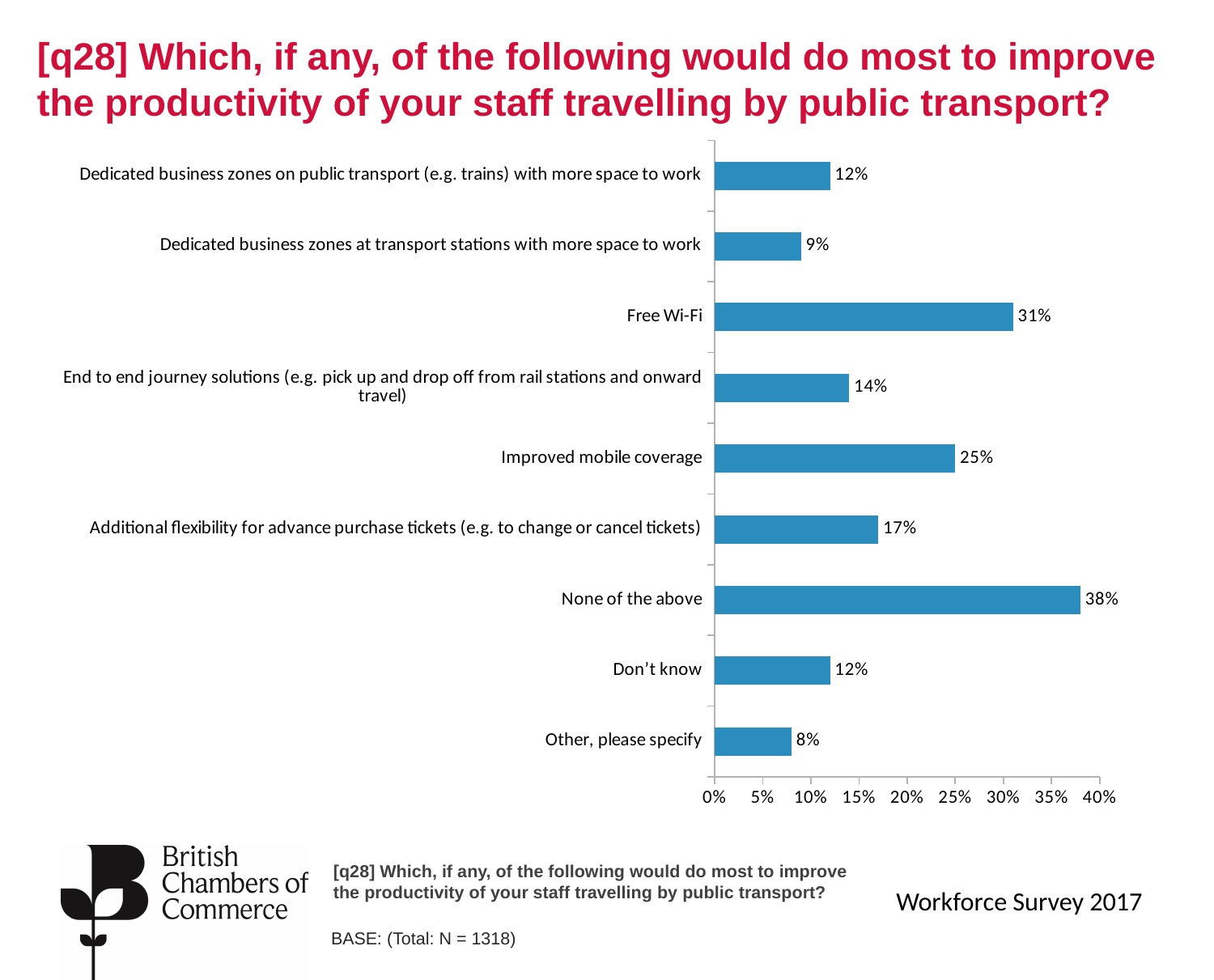
Which is larger: Dedicated business zones on public transport or Dedicated business zones at transport stations? Dedicated business zones on public transport What is the value for Improved mobile coverage? 25% What is the maximum value shown on the horizontal axis? 40% What percentage selected Additional flexibility for advance purchase tickets? 17% What percentage of respondents chose Free Wi-Fi? 31% Is the value for Free Wi-Fi greater or less than 30%? greater Which category has the highest value? None of the above Which category has the lowest value? Other, please specify What is the difference between Improved mobile coverage and End to end journey solutions? 11% How many categories are shown in the chart? 9 What is the difference between None of the above and Free Wi-Fi? 7% What kind of chart is shown on the slide? bar chart